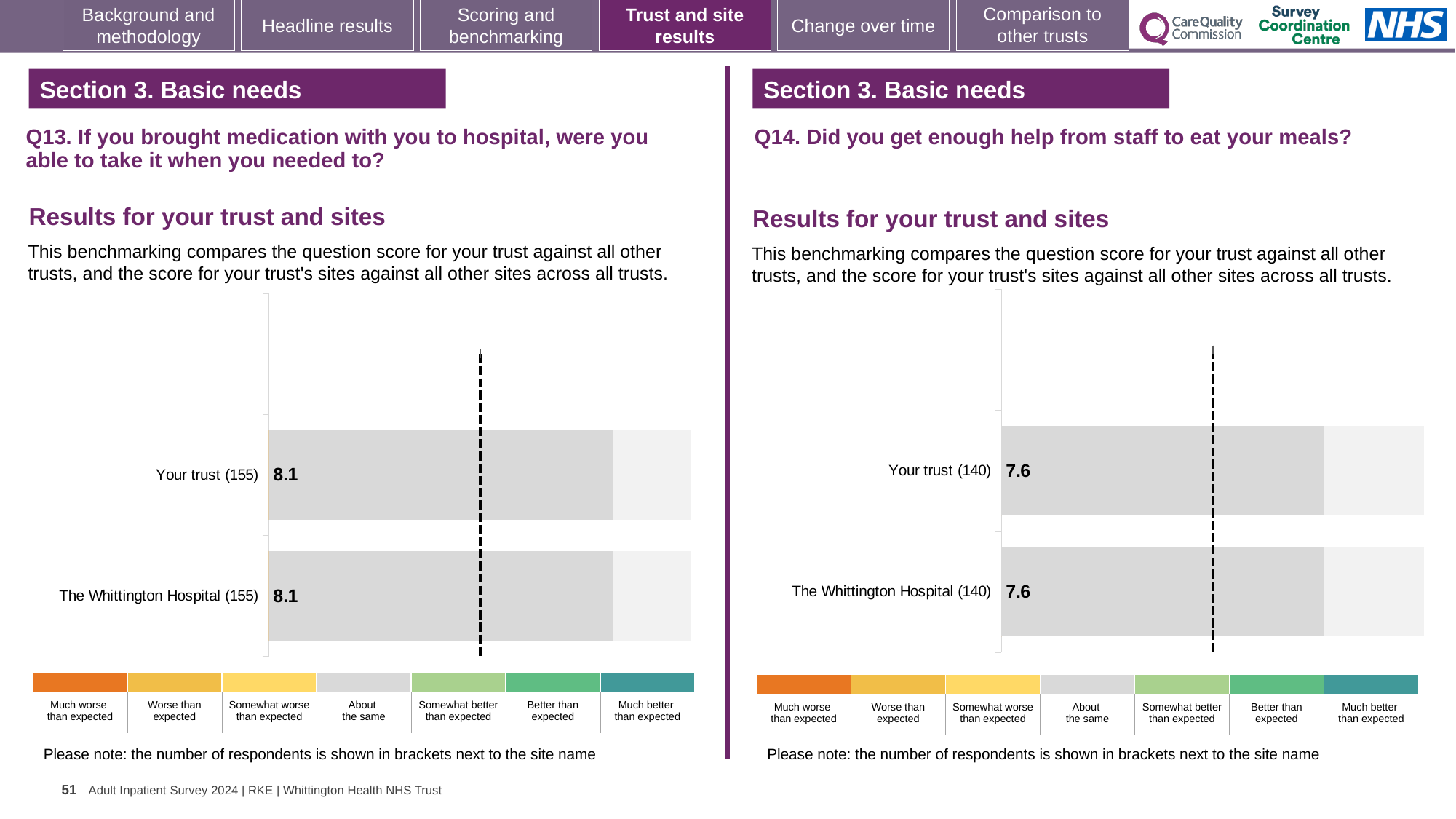
On the Q13 chart (left), what is the score for The Whittington Hospital? 8.1 What kind of chart is the Q13 chart (left)? Bar chart On the Q14 chart (right), what is the score for Your trust? 7.6 How many bars are plotted on the Q14 chart (right)? 2 On the Q13 chart (left), what is the difference between the score for Your trust and the score for The Whittington Hospital? 0 Is the score for Your trust on the Q13 chart (left) larger than the score for Your trust on the Q14 chart (right)? Yes On the Q14 chart (right), how many respondents are shown in brackets next to The Whittington Hospital? 140 How many bars are plotted on the Q13 chart (left)? 2 On the Q13 chart (left), how many respondents are shown in brackets next to Your trust? 155 On the Q14 chart (right), what is the score for The Whittington Hospital? 7.6 On the Q13 chart (left), what is the score for Your trust? 8.1 On the Q14 chart (right), what is the difference between the score for Your trust and the score for The Whittington Hospital? 0